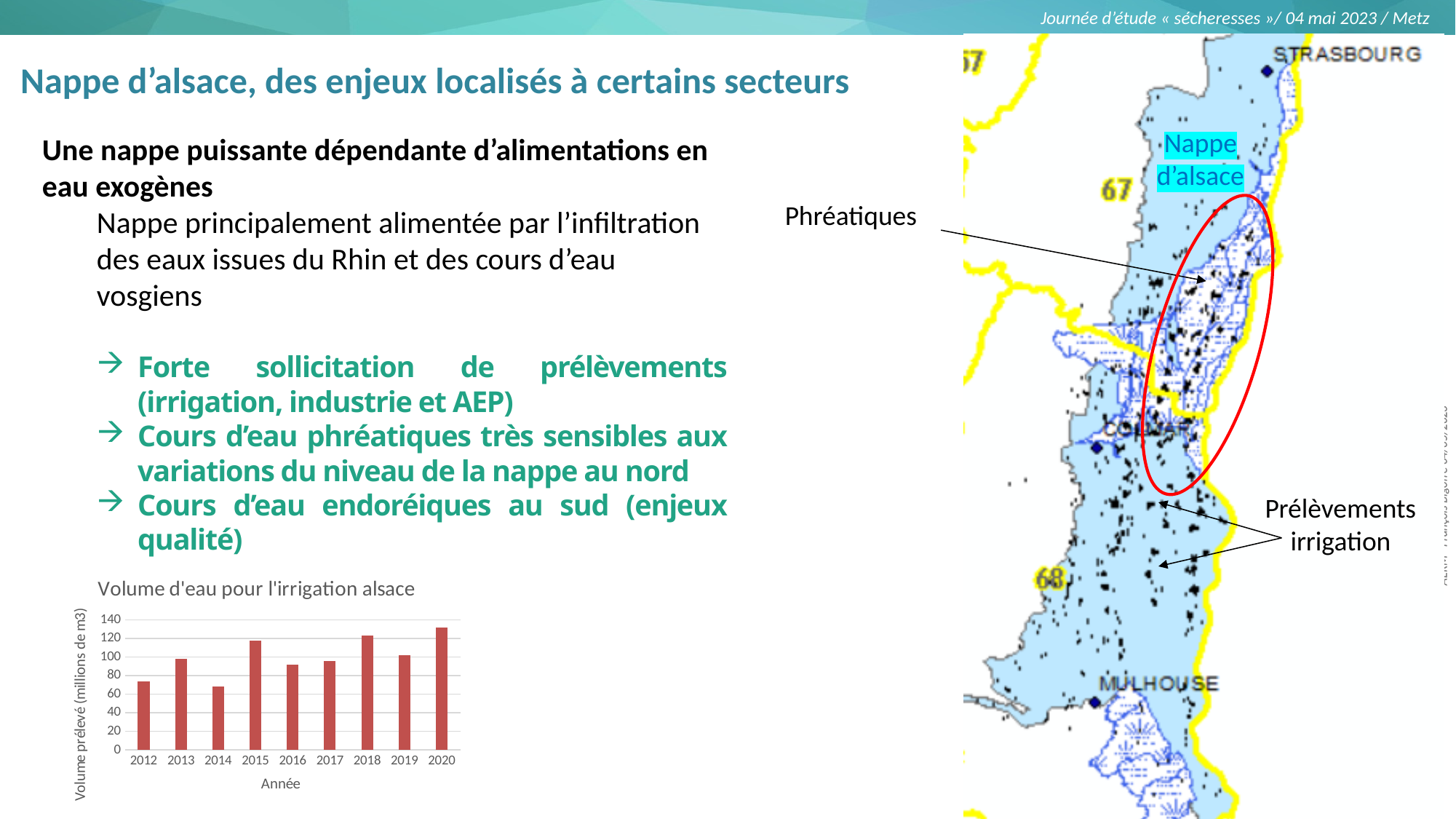
In the 'Volume d'eau pour l'irrigation alsace' chart, is the value for 2012 greater or less than 80? less What type of chart is 'Volume d'eau pour l'irrigation alsace'? bar chart In the 'Volume d'eau pour l'irrigation alsace' chart, is the value for 2020 greater or less than 120? greater In the 'Volume d'eau pour l'irrigation alsace' chart, which year has the highest volume? 2020 How many years are shown on the x axis of the 'Volume d'eau pour l'irrigation alsace' chart? 9 In the 'Volume d'eau pour l'irrigation alsace' chart, is the value for 2015 greater or less than 100? greater In the 'Volume d'eau pour l'irrigation alsace' chart, which year has the larger volume, 2018 or 2019? 2018 What is the label of the x axis of the 'Volume d'eau pour l'irrigation alsace' chart? Année In the 'Volume d'eau pour l'irrigation alsace' chart, which year has the larger volume, 2015 or 2016? 2015 What is the label of the y axis of the 'Volume d'eau pour l'irrigation alsace' chart? Volume prélevé (millions de m3)